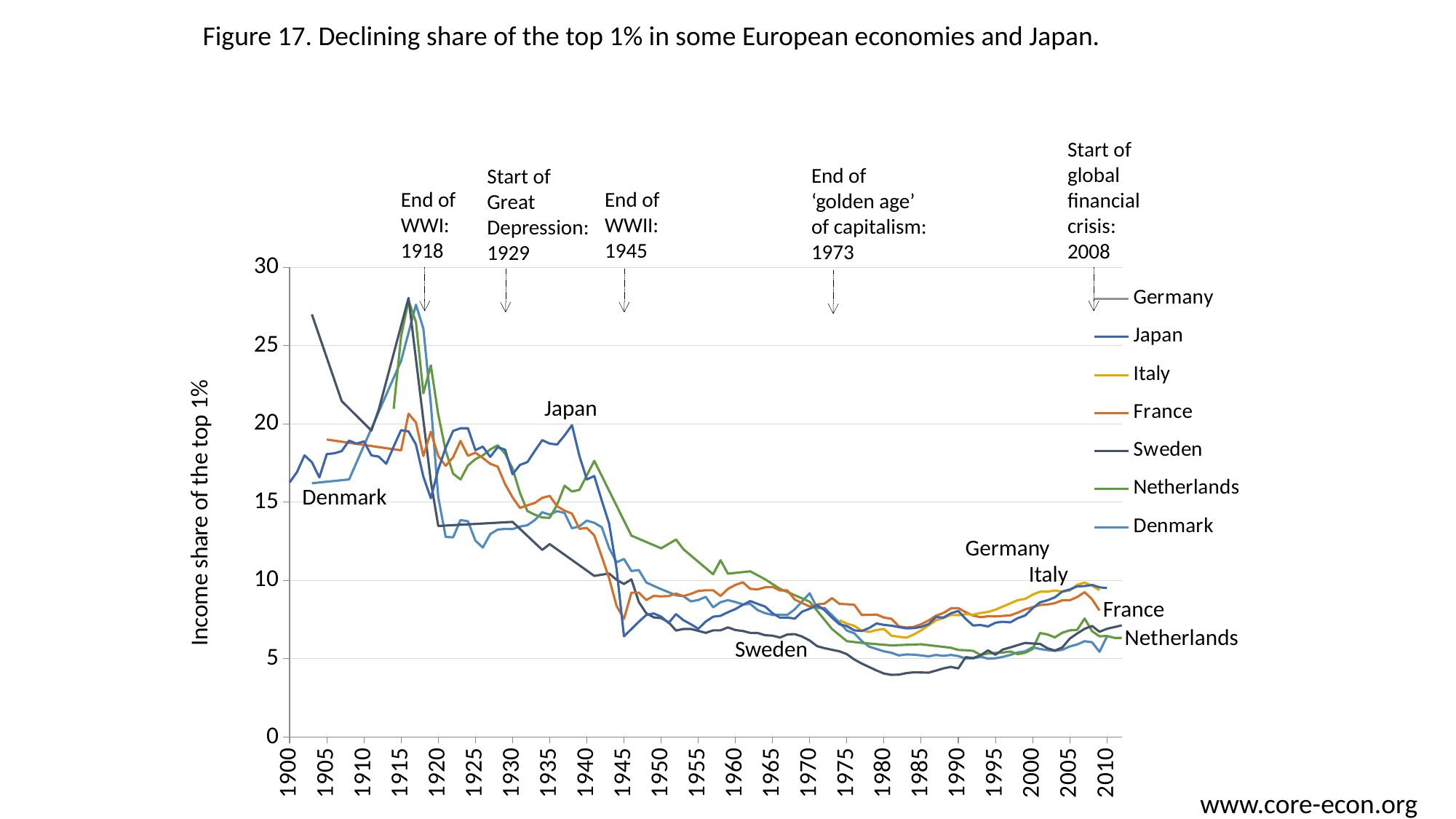
In 1938, which is larger, the value for Japan or the value for Sweden? Japan What is the label on the vertical axis? Income share of the top 1% Is the value for France in 1945 greater or less than 10? less Does the value for Sweden rise or fall overall from 1900 to 2010? fall How many series does the legend list? 7 Is the value for Sweden around 1982 greater or less than 5? less Which series has the lowest value around 1982? Sweden What kind of chart is shown on the slide? line chart Is the value for the Netherlands in 1950 greater or less than 10? greater What is the title of the chart? Figure 17. Declining share of the top 1% in some European economies and Japan. Which series has the highest value in 1903? Sweden